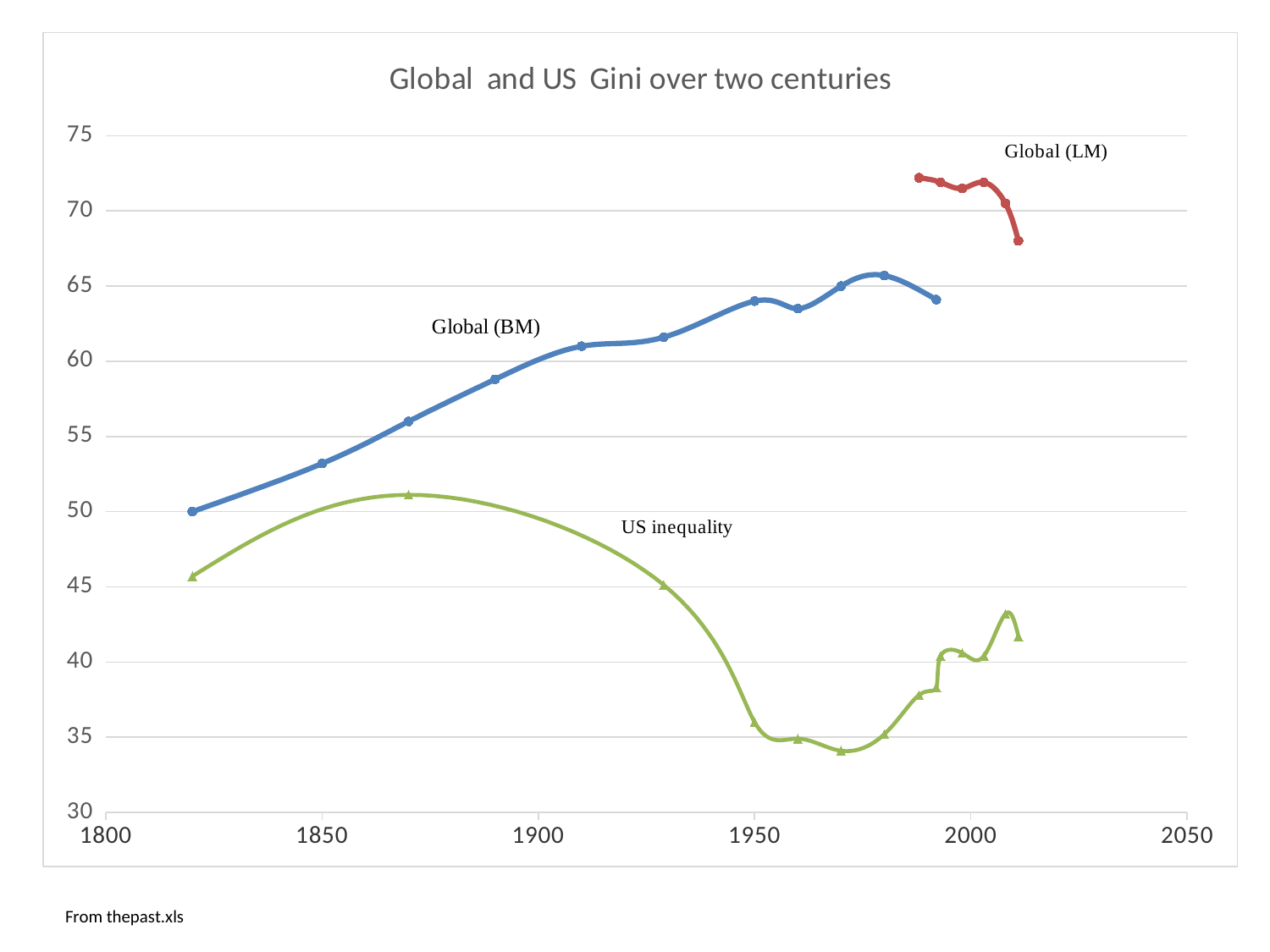
Around 1990, which series is higher: Global (LM) or Global (BM)? Global (LM) Does the US inequality series rise or fall between 1870 and 1970? fall Which series has the lowest values on the chart? US inequality Which series reaches the highest values on the chart? Global (LM) How many data series are plotted on the chart? 3 Is the last plotted value of Global (LM), around 2010, greater or less than 70? less What kind of chart is shown on the slide? line chart Is the value of Global (BM) in 1850 greater or less than 55? less Is the value of Global (BM) in 1890 greater or less than 55? greater What is the title of the chart? Global and US Gini over two centuries